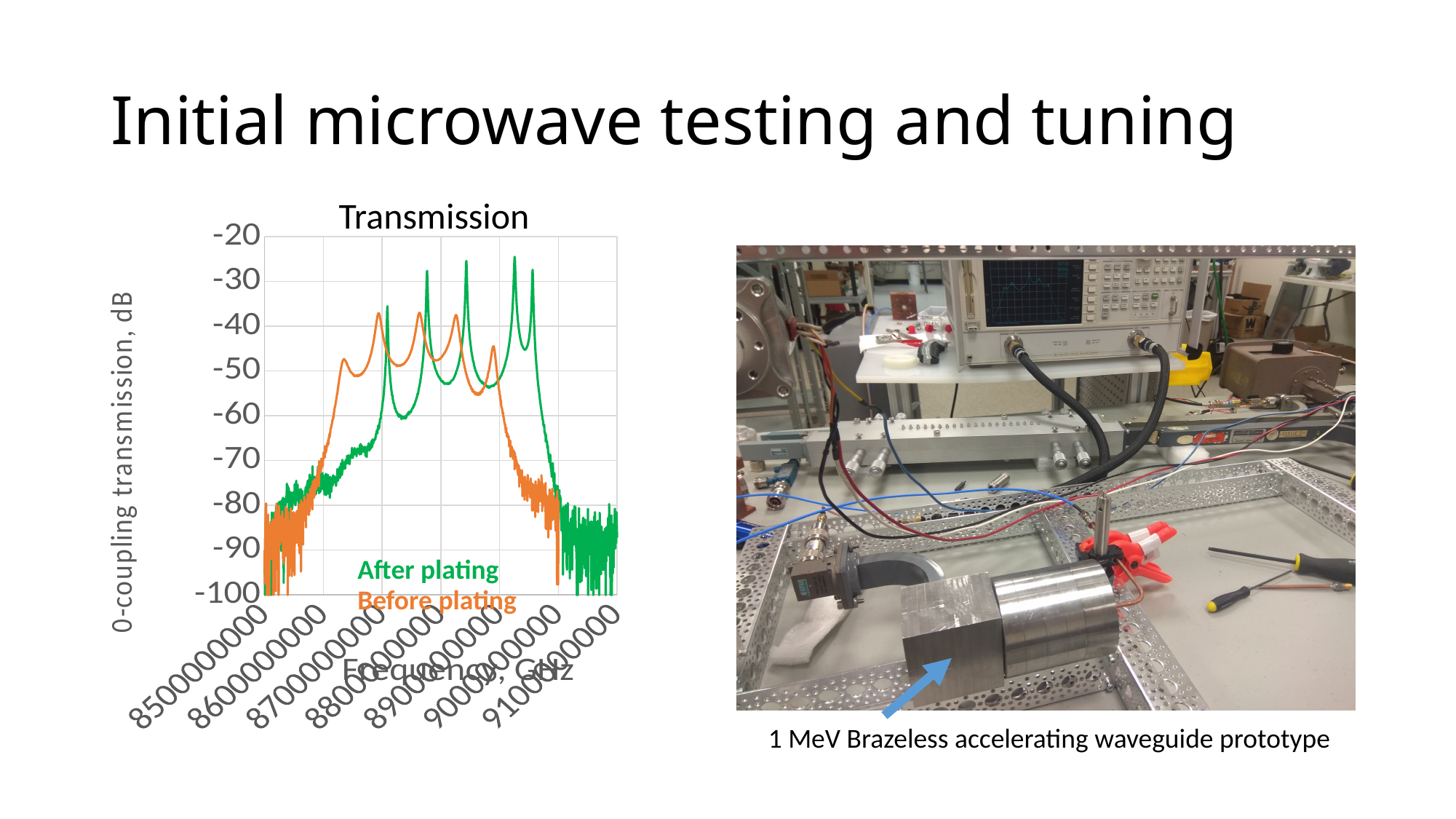
Is the highest value reached by the After plating series greater or less than -30? greater Is the value of the After plating series at 9100000000 greater or less than -70? less Does the After plating series generally rise or fall between 8500000000 and 8900000000 on the x axis? rise Is the highest value reached by the Before plating series greater or less than -20? less How many series does the Transmission chart show? 2 What kind of chart is shown on the slide? line chart Which colour is used for the After plating series in the Transmission chart? green Which series reaches a higher peak value in the Transmission chart, After plating or Before plating? After plating How many labelled tick marks are shown on the x axis of the Transmission chart? 7 Does the Before plating series generally rise or fall between 9000000000 and 9100000000 on the x axis? fall What is the title of the chart on the slide? Transmission